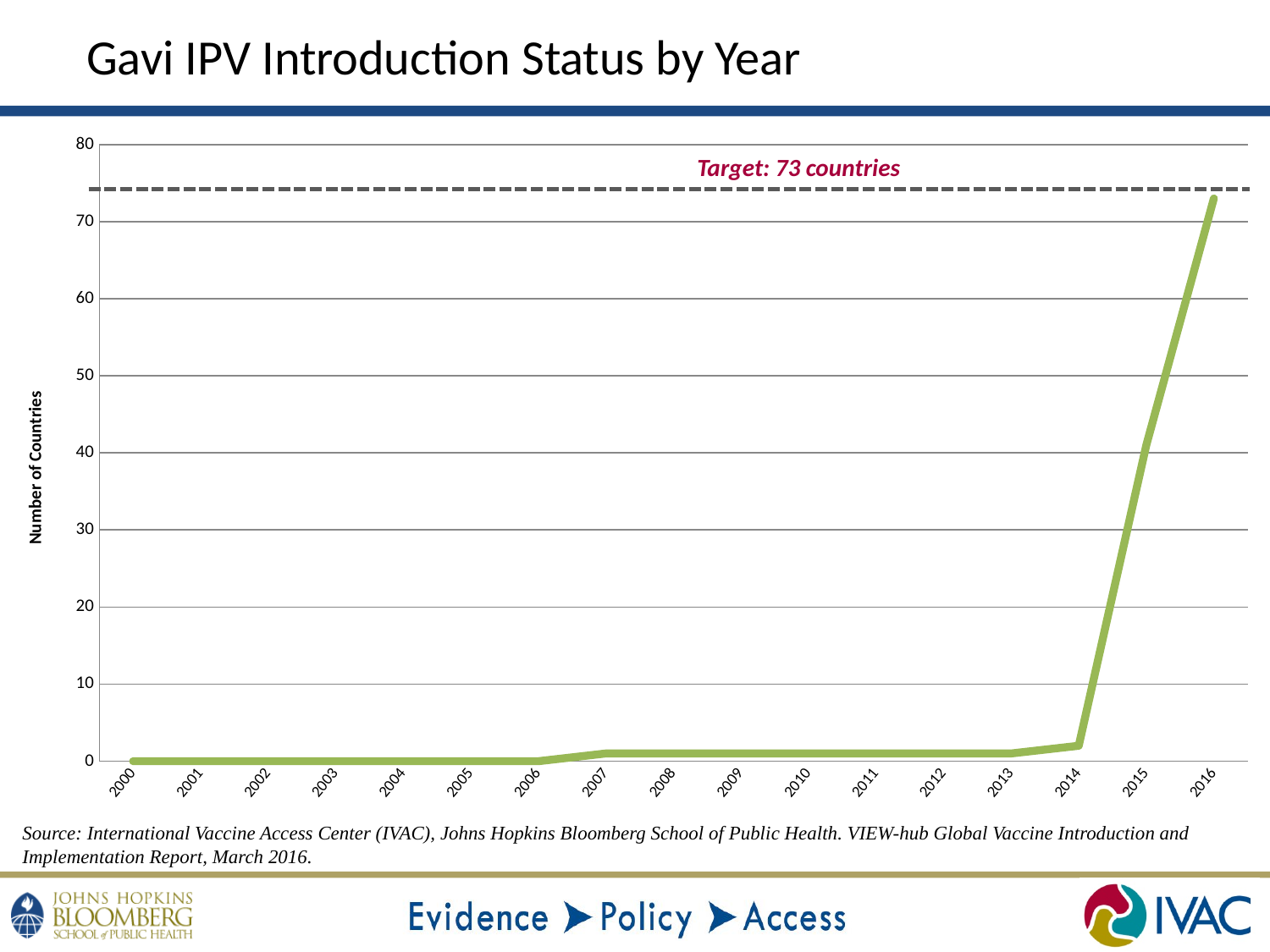
Is the value for 2010 greater or less than 10? less Which year has the highest number of countries? 2016 Is the value for 2014 greater or less than 10? less What target value is marked by the dashed line on the chart? 73 countries Do the values generally rise or fall from 2000 to 2016? rise What is the title of the chart? Gavi IPV Introduction Status by Year Is the value for 2015 greater or less than 20? greater What kind of chart is shown on the slide? line chart How many years are plotted along the x axis? 17 Which year has the larger number of countries, 2013 or 2015? 2015 Which year has the larger number of countries, 2015 or 2016? 2016